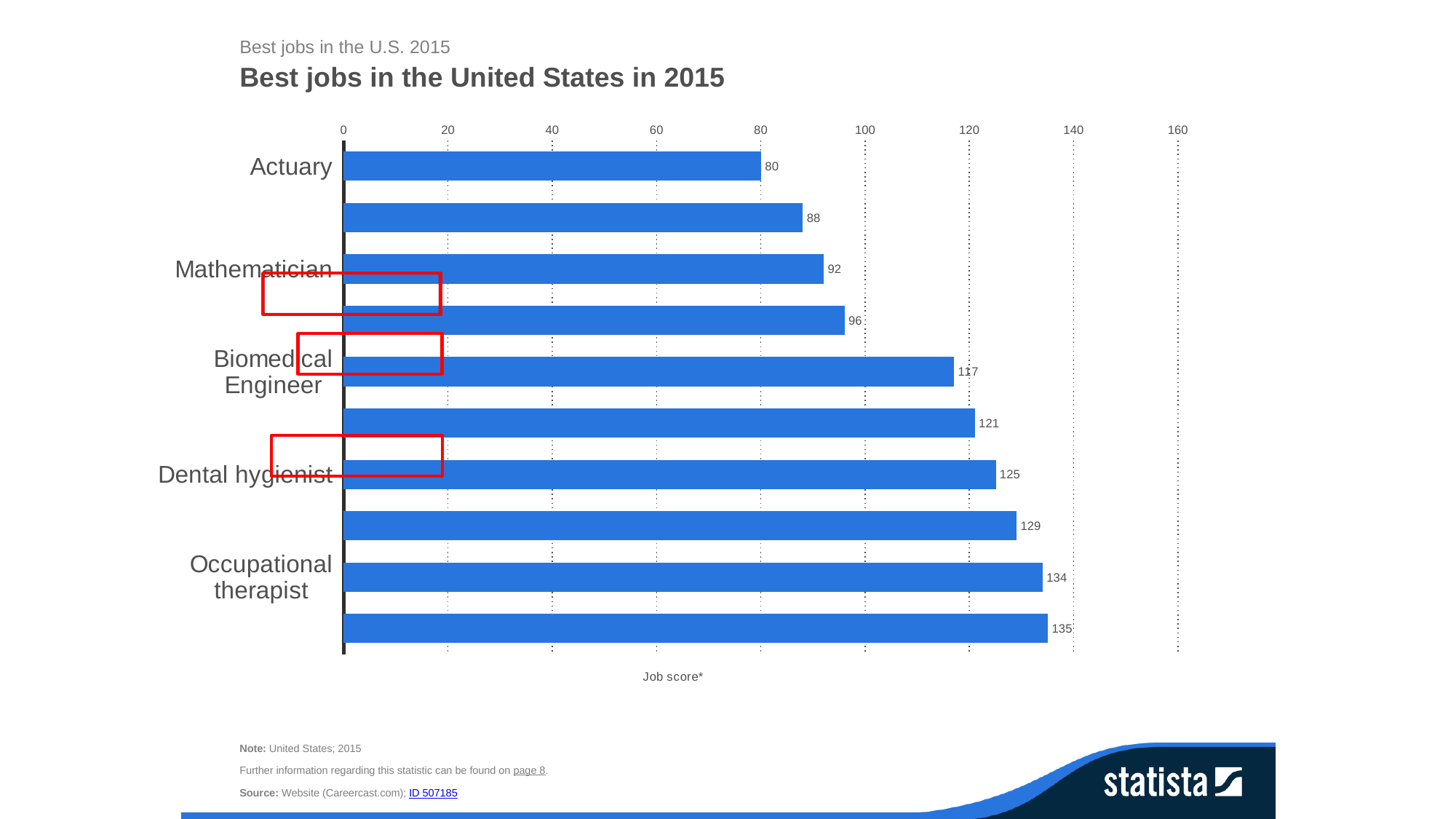
Which has a higher job score, Biomedical Engineer or Dental hygienist? Dental hygienist What is the job score for Occupational therapist? 134 What type of chart is shown on the slide? Bar chart What is the job score for Mathematician? 92 What is the difference in job score between Dental hygienist and Mathematician? 33 Which labelled job has the lowest job score? Actuary How many bars are plotted on the chart? 10 What is the job score for Actuary? 80 What is the difference in job score between Occupational therapist and Actuary? 54 Is the job score for Biomedical Engineer greater or less than 100? greater What is the job score for Biomedical Engineer? 117 What is the job score for Dental hygienist? 125